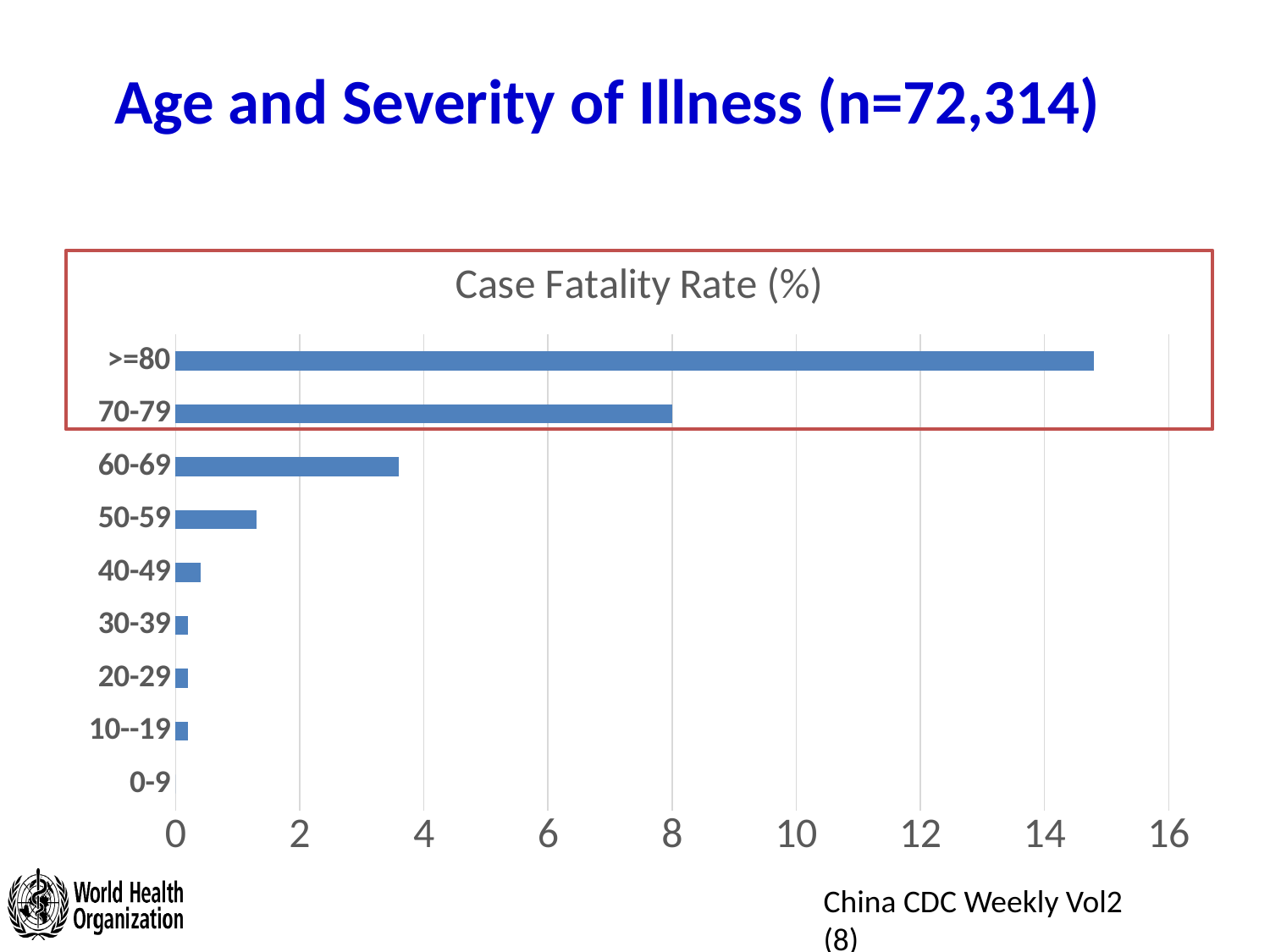
What kind of chart is shown on the slide? bar chart Which age group has the highest case fatality rate? >=80 Which age group has a higher case fatality rate, 70-79 or >=80? >=80 Do case fatality rates rise or fall as age group increases from 0-9 to >=80? rise Which age group has a higher case fatality rate, 60-69 or 50-59? 60-69 Is the case fatality rate for the 50-59 age group greater or less than 2? less Is the case fatality rate for the >=80 age group greater or less than 14? greater Which age group has the lowest case fatality rate? 0-9 Is the case fatality rate for the 60-69 age group greater or less than 2? greater What is the title of the chart? Case Fatality Rate (%) How many age categories are shown in the chart? 9